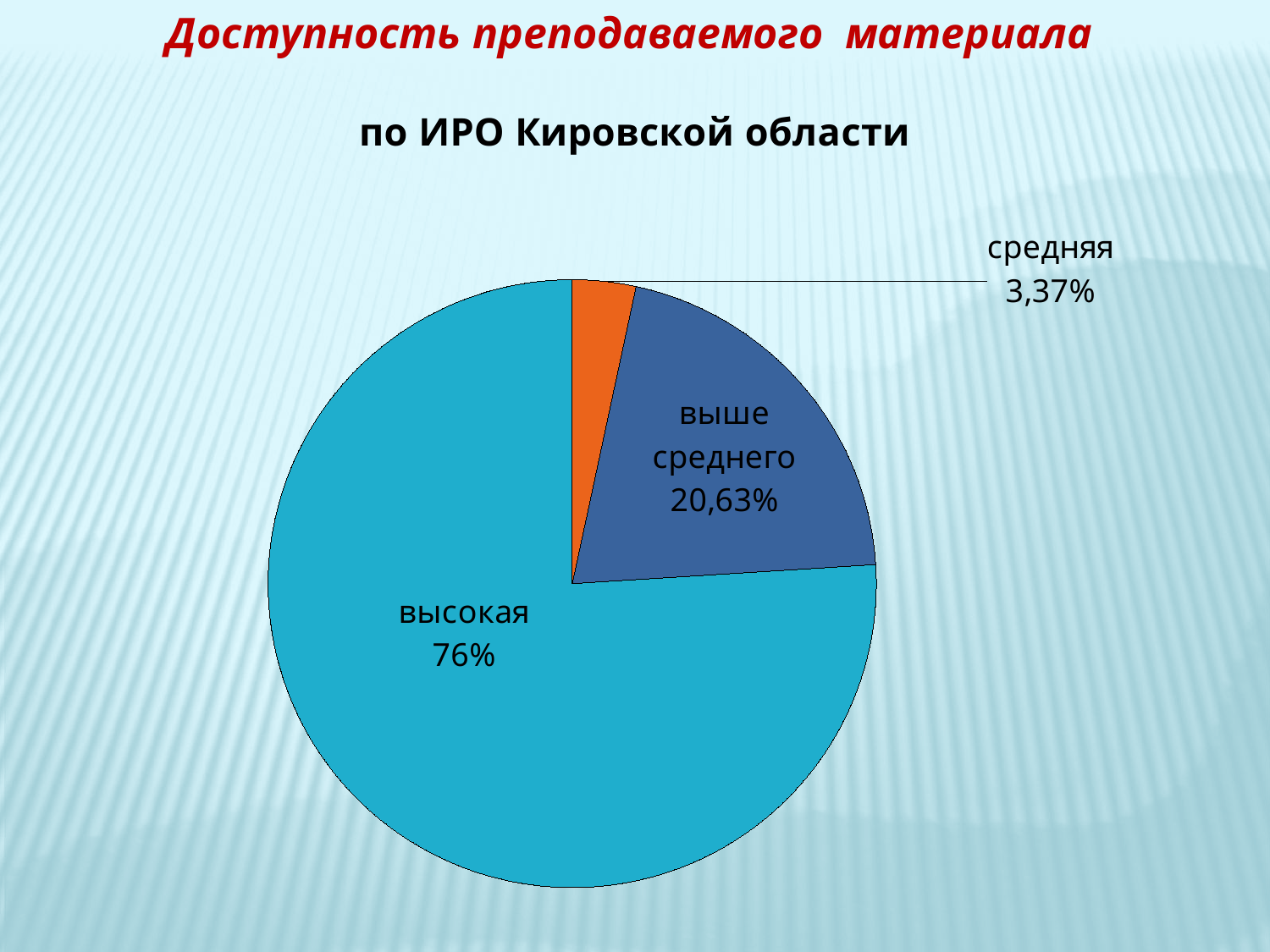
What type of chart is shown on the slide? pie chart Which is larger, the slice "выше среднего" or the slice "средняя"? выше среднего Which slice of the pie is the largest? высокая Which slice of the pie is the smallest? средняя What share of the pie does the slice "выше среднего" have? 20,63% What share of the pie does the slice "средняя" have? 3,37% How many slices does the pie chart have? 3 What is the difference between the shares of "высокая" and "выше среднего"? 55,37% What share of the pie does the slice "высокая" have? 76% What colour is the slice "средняя"? orange What is the difference between the shares of "выше среднего" and "средняя"? 17,26% What colour is the slice "высокая"? light blue